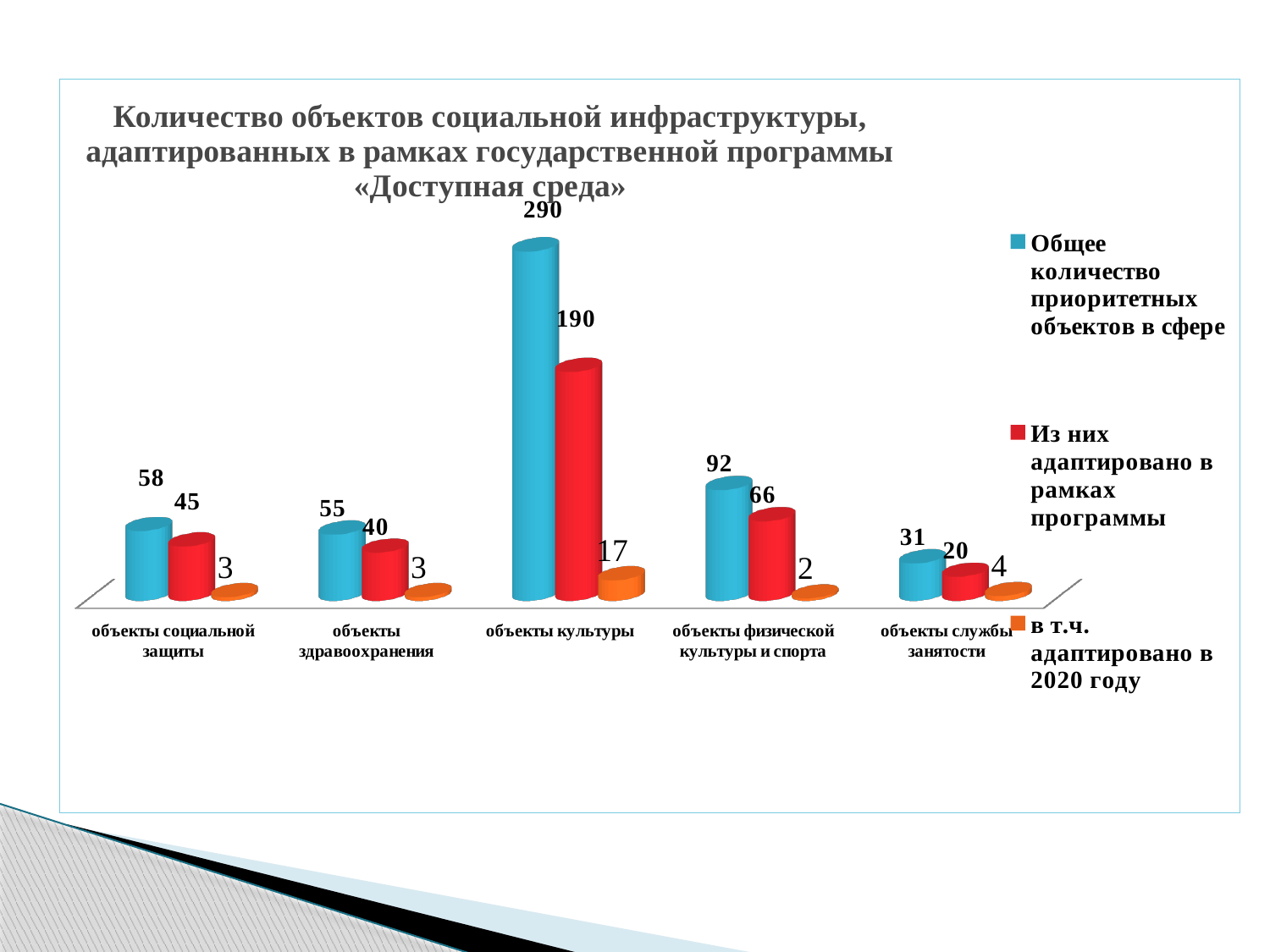
Which is larger: the number adapted within the programme for объекты здравоохранения or for объекты службы занятости? объекты здравоохранения How many series does the legend list? 3 Which colour represents the series 'в т.ч. адаптировано в 2020 году'? orange How many objects were adapted in 2020 (в т.ч. адаптировано в 2020 году) for объекты культуры? 17 How many objects were adapted within the programme (Из них адаптировано в рамках программы) for объекты физической культуры и спорта? 66 What is the total number of priority objects (Общее количество приоритетных объектов в сфере) for объекты культуры? 290 Which category has the highest total number of priority objects? объекты культуры What is the difference between the number adapted within the programme and the number adapted in 2020 for объекты культуры? 173 What kind of chart is shown on the slide? bar chart What is the difference between the total number of priority objects and the number adapted within the programme for объекты социальной защиты? 13 Which category has the lowest total number of priority objects? объекты службы занятости How many categories are shown on the x axis? 5